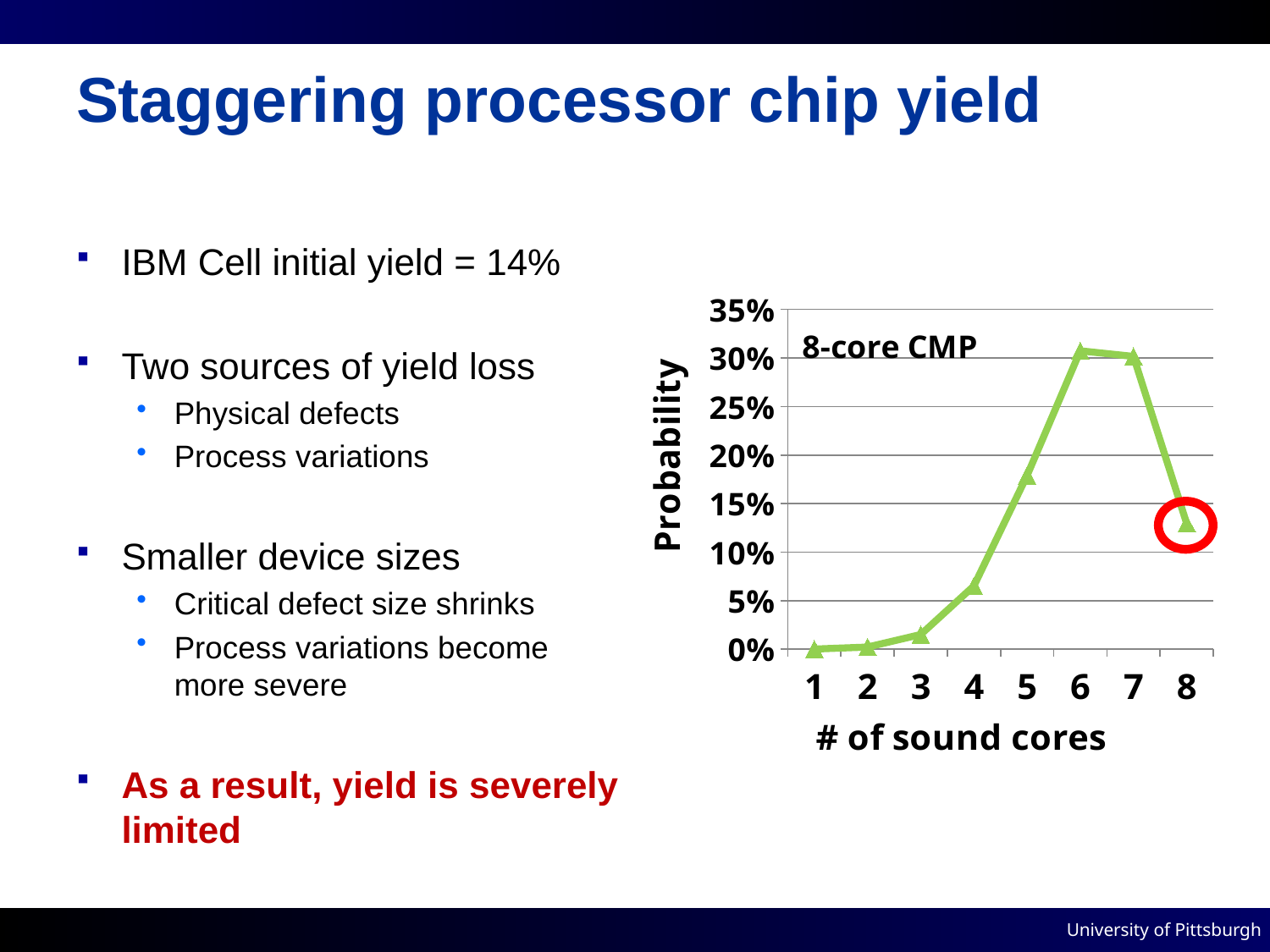
Which has a higher probability: 6 sound cores or 8 sound cores? 6 sound cores How many data points are plotted on the chart? 8 Is the probability for 3 sound cores greater or less than 5%? less Is the probability for 8 sound cores greater or less than 15%? less What kind of chart is shown on the slide? line chart Which has a higher probability: 4 sound cores or 5 sound cores? 5 sound cores What is the label of the x axis of the chart? # of sound cores How does the probability change as the number of sound cores goes from 1 to 6? it rises What is the title shown inside the chart? 8-core CMP Is the probability for 8 sound cores greater or less than 10%? greater